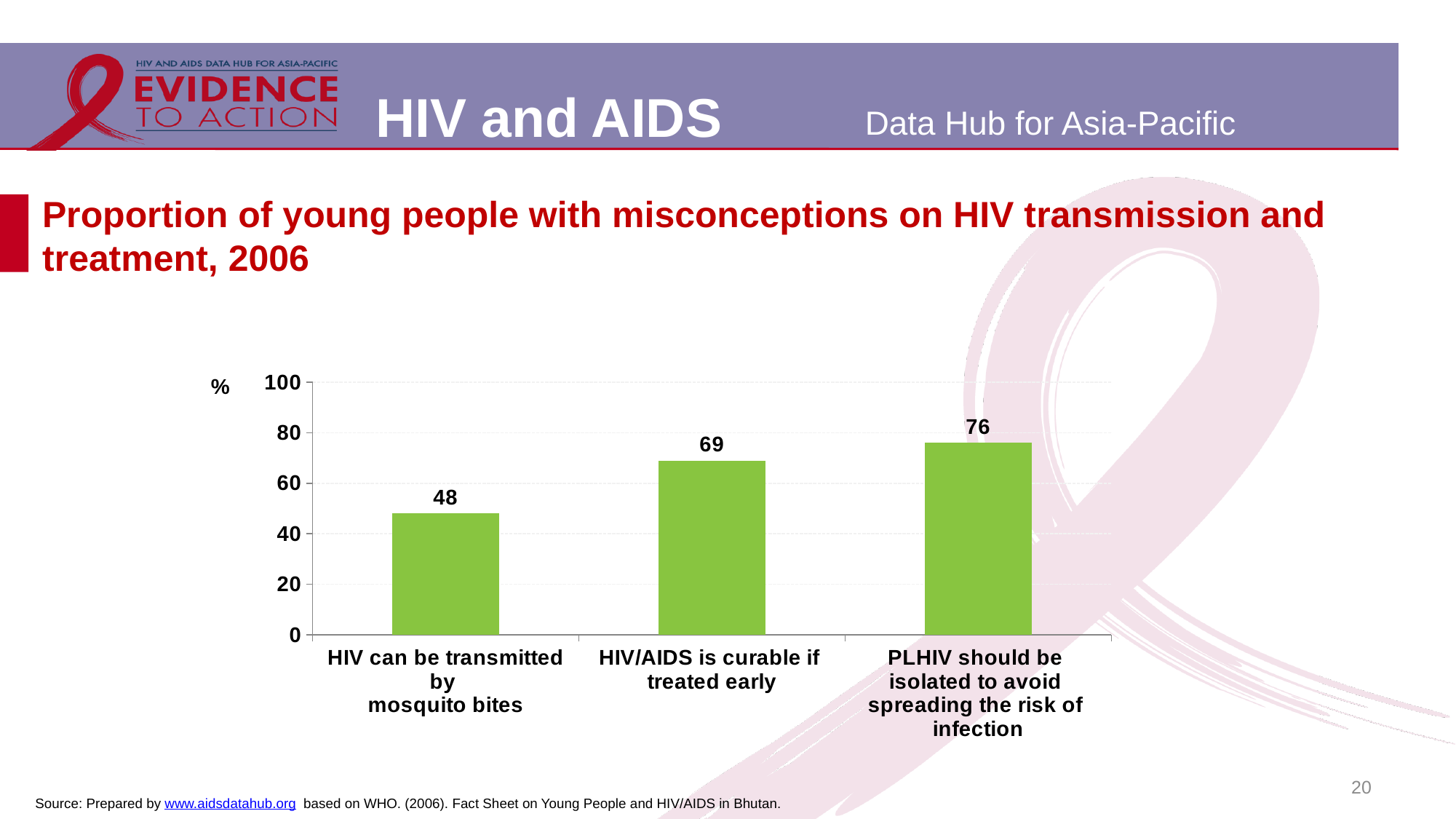
What percentage of young people believe PLHIV should be isolated to avoid spreading the risk of infection? 76 Which is larger: the proportion believing HIV/AIDS is curable if treated early or the proportion believing PLHIV should be isolated? PLHIV should be isolated Which misconception has the lowest proportion of young people? HIV can be transmitted by mosquito bites Is the value for 'HIV can be transmitted by mosquito bites' greater or less than 60? less What type of chart is shown on the slide? bar chart What is the difference between the proportion believing PLHIV should be isolated and the proportion believing HIV can be transmitted by mosquito bites? 28 What percentage of young people believe HIV can be transmitted by mosquito bites? 48 How many misconception categories are shown in the chart? 3 Which misconception has the highest proportion of young people? PLHIV should be isolated to avoid spreading the risk of infection What is the difference between the proportion believing HIV/AIDS is curable if treated early and the proportion believing HIV can be transmitted by mosquito bites? 21 What unit is shown on the vertical axis of the chart? % What percentage of young people believe HIV/AIDS is curable if treated early? 69